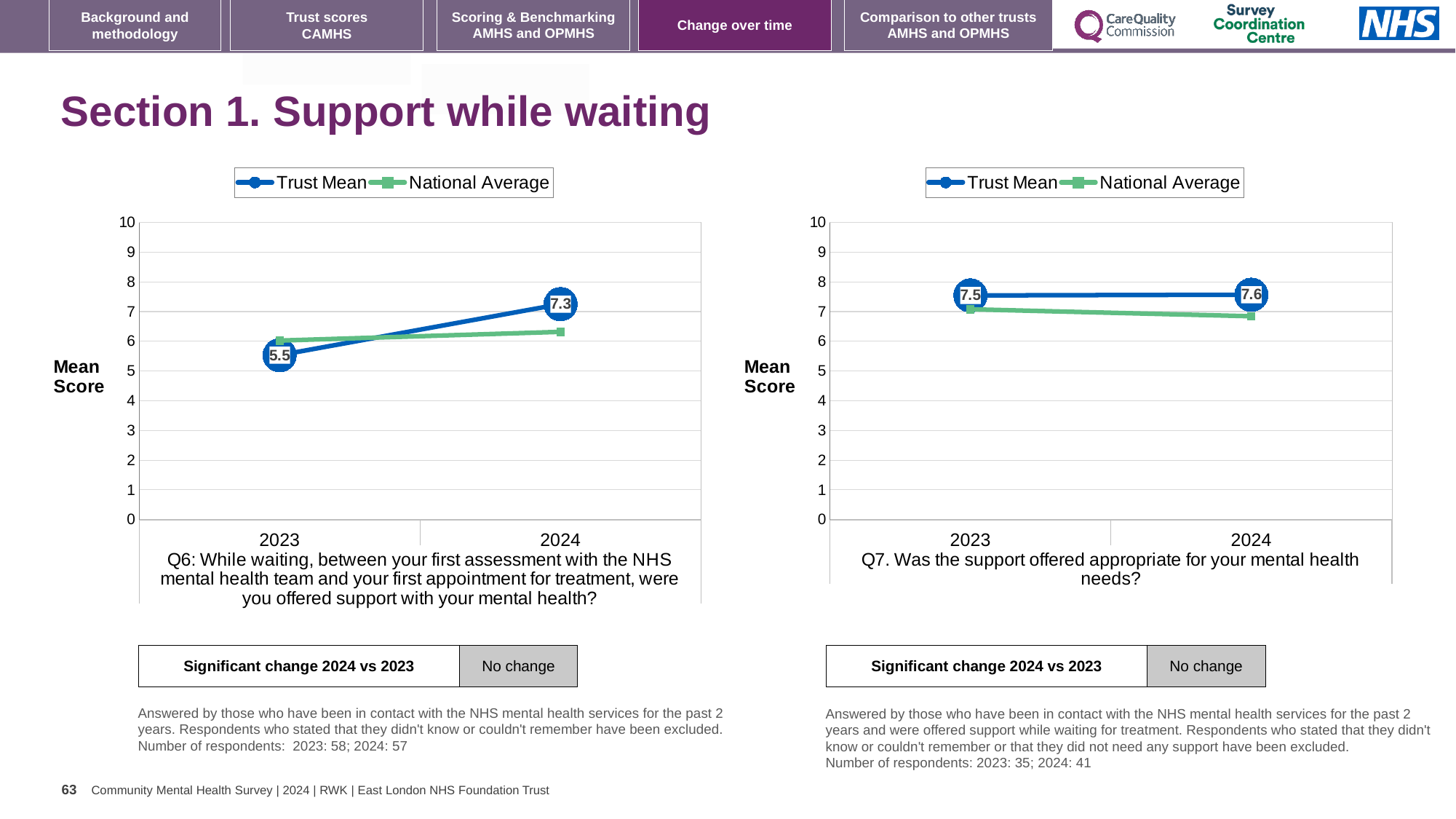
In the right chart (Q7), what is the Trust Mean score for 2023? 7.5 In the left chart (Q6), what is the Trust Mean score for 2023? 5.5 In the right chart (Q7), does the National Average rise or fall from 2023 to 2024? fall How many series does the legend of the right chart (Q7) list? 2 In the right chart (Q7), what is the Trust Mean score for 2024? 7.6 In the left chart (Q6), what is the Trust Mean score for 2024? 7.3 In the left chart (Q6), is the National Average for 2023 greater or less than 5? greater In the left chart (Q6), by how much did the Trust Mean change from 2023 to 2024? 1.8 In the right chart (Q7), which is larger for 2024, the Trust Mean or the National Average? Trust Mean How many years are shown on the x axis of the left chart (Q6)? 2 In the left chart (Q6), does the Trust Mean rise or fall from 2023 to 2024? rise What type of chart is used on the left (Q6)? line chart